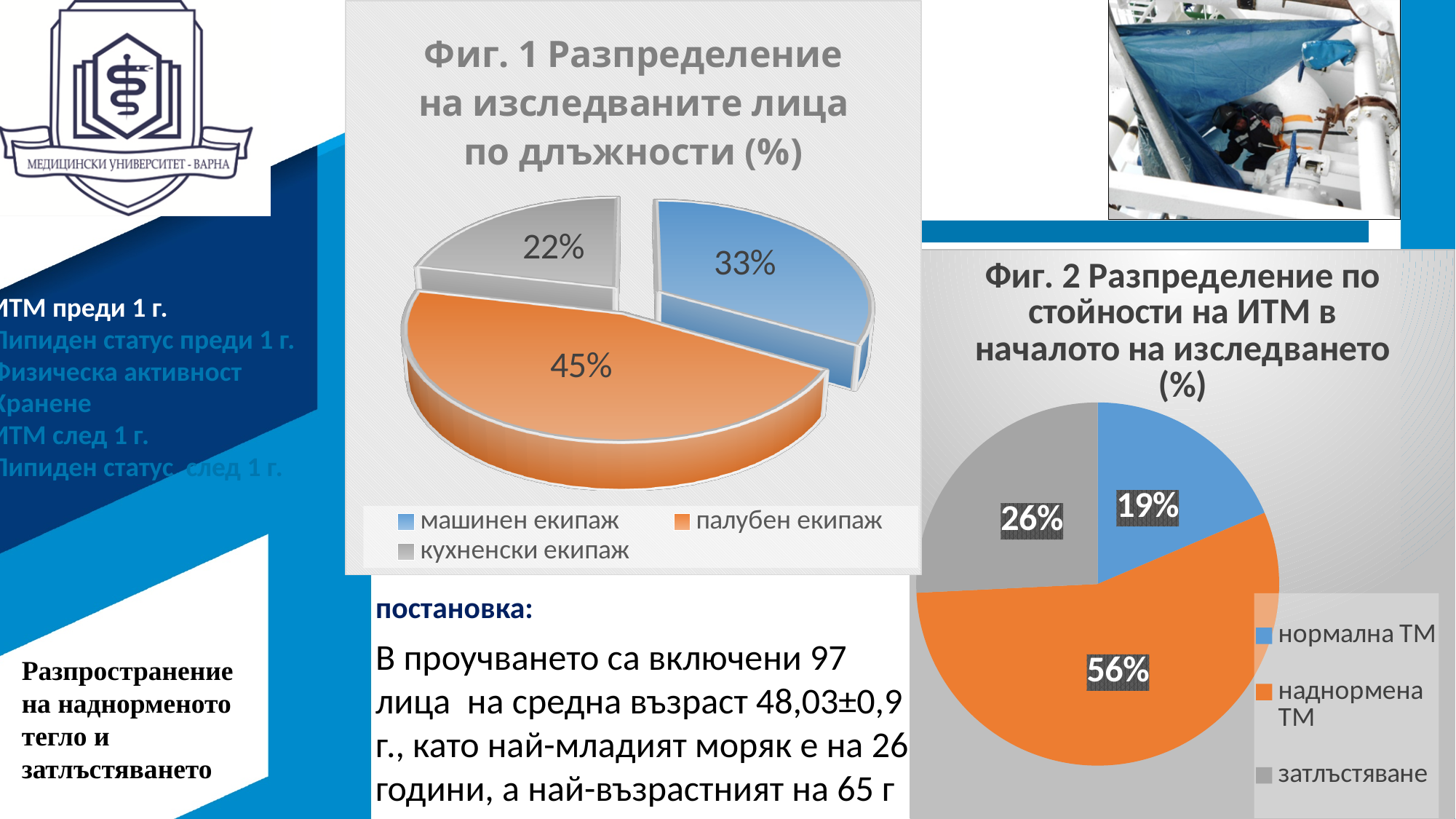
In the chart titled "Фиг. 2 Разпределение по стойности на ИТМ в началото на изследването (%)", which is larger: "нормална ТМ" or "затлъстяване"? затлъстяване In the chart titled "Фиг. 1 Разпределение на изследваните лица по длъжности (%)", what is the difference between the shares of "палубен екипаж" and "кухненски екипаж"? 23% In the chart titled "Фиг. 1 Разпределение на изследваните лица по длъжности (%)", which category has the smallest slice? кухненски екипаж In the chart titled "Фиг. 2 Разпределение по стойности на ИТМ в началото на изследването (%)", what colour is the slice for "нормална ТМ"? blue In the chart titled "Фиг. 2 Разпределение по стойности на ИТМ в началото на изследването (%)", what is the difference between the shares of "наднормена ТМ" and "нормална ТМ"? 37% In the chart titled "Фиг. 1 Разпределение на изследваните лица по длъжности (%)", how many slices does the pie have? 3 What kind of chart is "Фиг. 1 Разпределение на изследваните лица по длъжности (%)"? pie chart In the chart titled "Фиг. 2 Разпределение по стойности на ИТМ в началото на изследването (%)", which category has the largest slice? наднормена ТМ In the chart titled "Фиг. 2 Разпределение по стойности на ИТМ в началото на изследването (%)", what share is shown for "затлъстяване"? 26% In the chart titled "Фиг. 1 Разпределение на изследваните лица по длъжности (%)", what share is shown for "палубен екипаж"? 45% In the chart titled "Фиг. 1 Разпределение на изследваните лица по длъжности (%)", what share is shown for "машинен екипаж"? 33% In the chart titled "Фиг. 2 Разпределение по стойности на ИТМ в началото на изследването (%)", what share is shown for "наднормена ТМ"? 56%